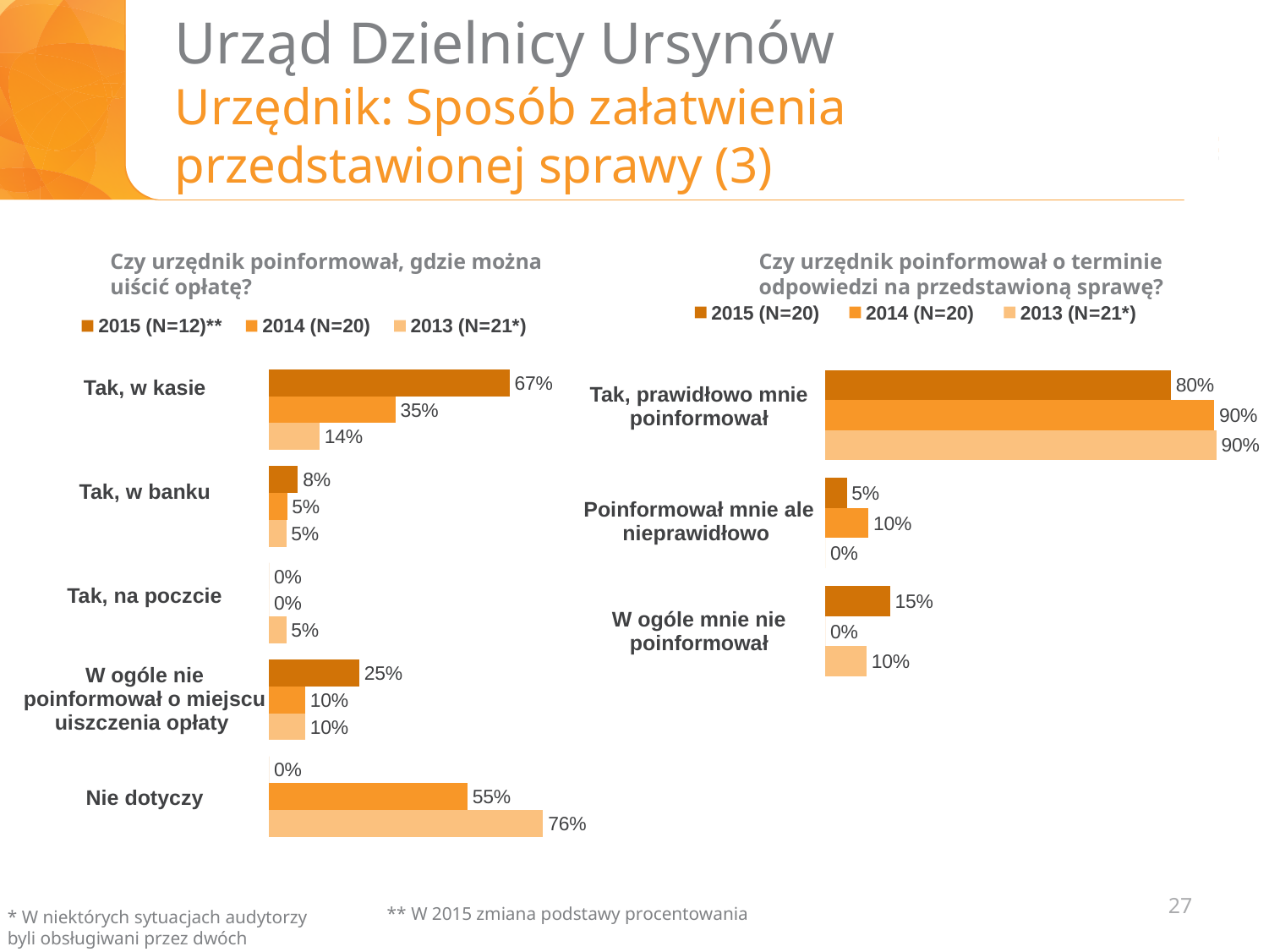
In the left chart ("Czy urzędnik poinformował, gdzie można uiścić opłatę?"), how many series does the legend list? 3 In the left chart ("Czy urzędnik poinformował, gdzie można uiścić opłatę?"), what is the 2013 value for "Nie dotyczy"? 76% In the right chart ("Czy urzędnik poinformował o terminie odpowiedzi na przedstawioną sprawę?"), what is the difference between the 2014 and 2015 values for "Tak, prawidłowo mnie poinformował"? 10 percentage points In the left chart ("Czy urzędnik poinformował, gdzie można uiścić opłatę?"), which category has the highest 2015 value? Tak, w kasie In the left chart ("Czy urzędnik poinformował, gdzie można uiścić opłatę?"), what is the 2015 value for "Tak, w kasie"? 67% In the right chart ("Czy urzędnik poinformował o terminie odpowiedzi na przedstawioną sprawę?"), what is the 2015 value for "Tak, prawidłowo mnie poinformował"? 80% In the right chart ("Czy urzędnik poinformował o terminie odpowiedzi na przedstawioną sprawę?"), what is the 2015 value for "W ogóle mnie nie poinformował"? 15% In the right chart ("Czy urzędnik poinformował o terminie odpowiedzi na przedstawioną sprawę?"), which is larger for "Poinformował mnie ale nieprawidłowo": the 2015 value or the 2014 value? 2014 What type of chart is the right chart ("Czy urzędnik poinformował o terminie odpowiedzi na przedstawioną sprawę?")? Bar chart In the left chart ("Czy urzędnik poinformował, gdzie można uiścić opłatę?"), what is the difference between the 2015 and 2014 values for "Tak, w kasie"? 32 percentage points In the left chart ("Czy urzędnik poinformował, gdzie można uiścić opłatę?"), what is the 2014 value for "W ogóle nie poinformował o miejscu uiszczenia opłaty"? 10% In the left chart ("Czy urzędnik poinformował, gdzie można uiścić opłatę?"), how many categories are shown? 5